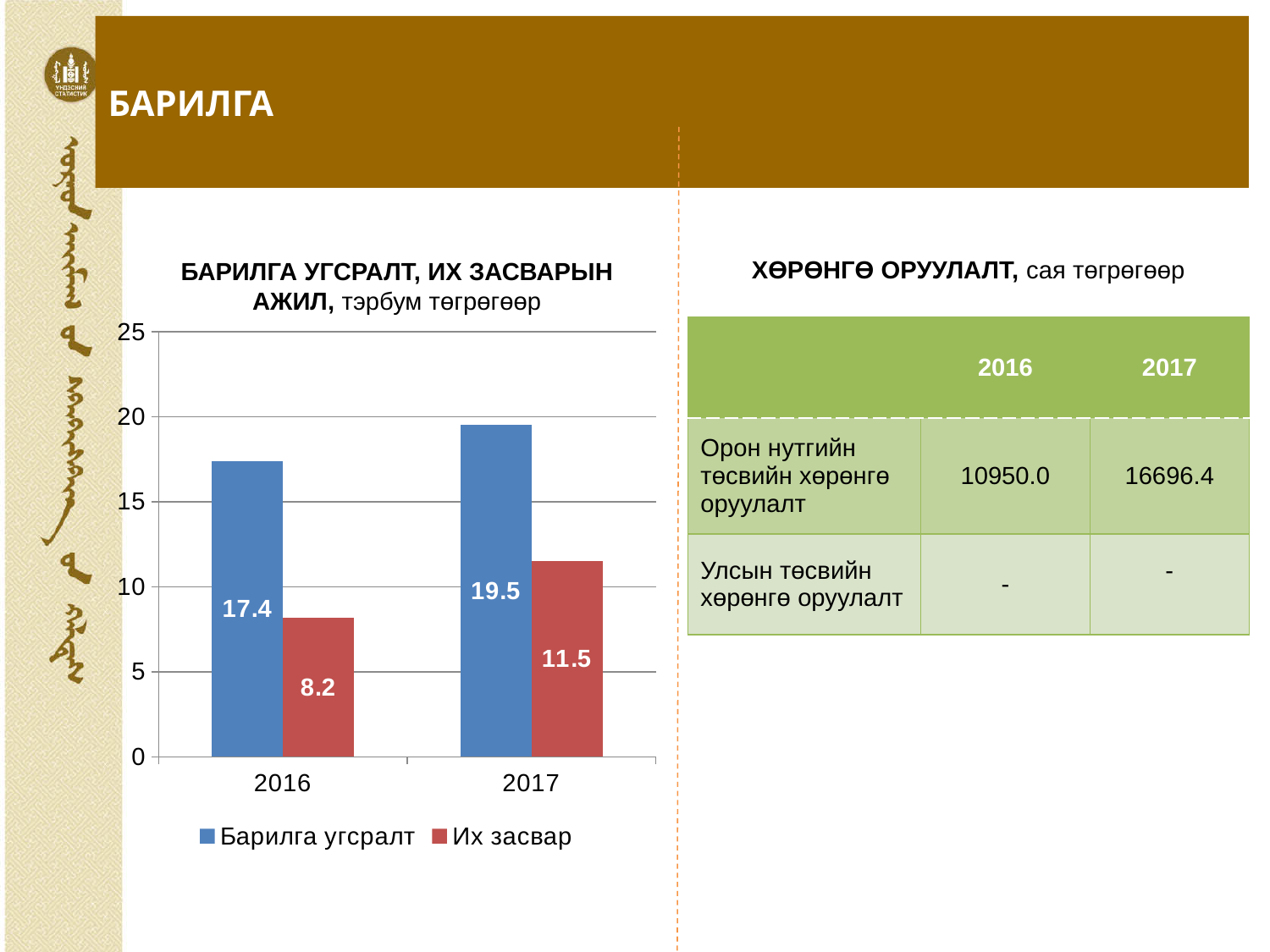
What is the difference between Барилга угсралт and Их засвар in 2017? 8.0 How many series does the legend list? 2 What is the value for Их засвар in 2017? 11.5 What is the value for Их засвар in 2016? 8.2 What is the value for Барилга угсралт in 2017? 19.5 Which year has the higher value for Барилга угсралт? 2017 What is the difference between the Их засвар values for 2017 and 2016? 3.3 Does the value for Их засвар rise or fall from 2016 to 2017? Rise What kind of chart is shown on the slide? Bar chart Which series has the lowest value in 2016? Их засвар What is the value for Барилга угсралт in 2016? 17.4 Which is larger: Их засвар in 2017 or Барилга угсралт in 2016? Барилга угсралт in 2016